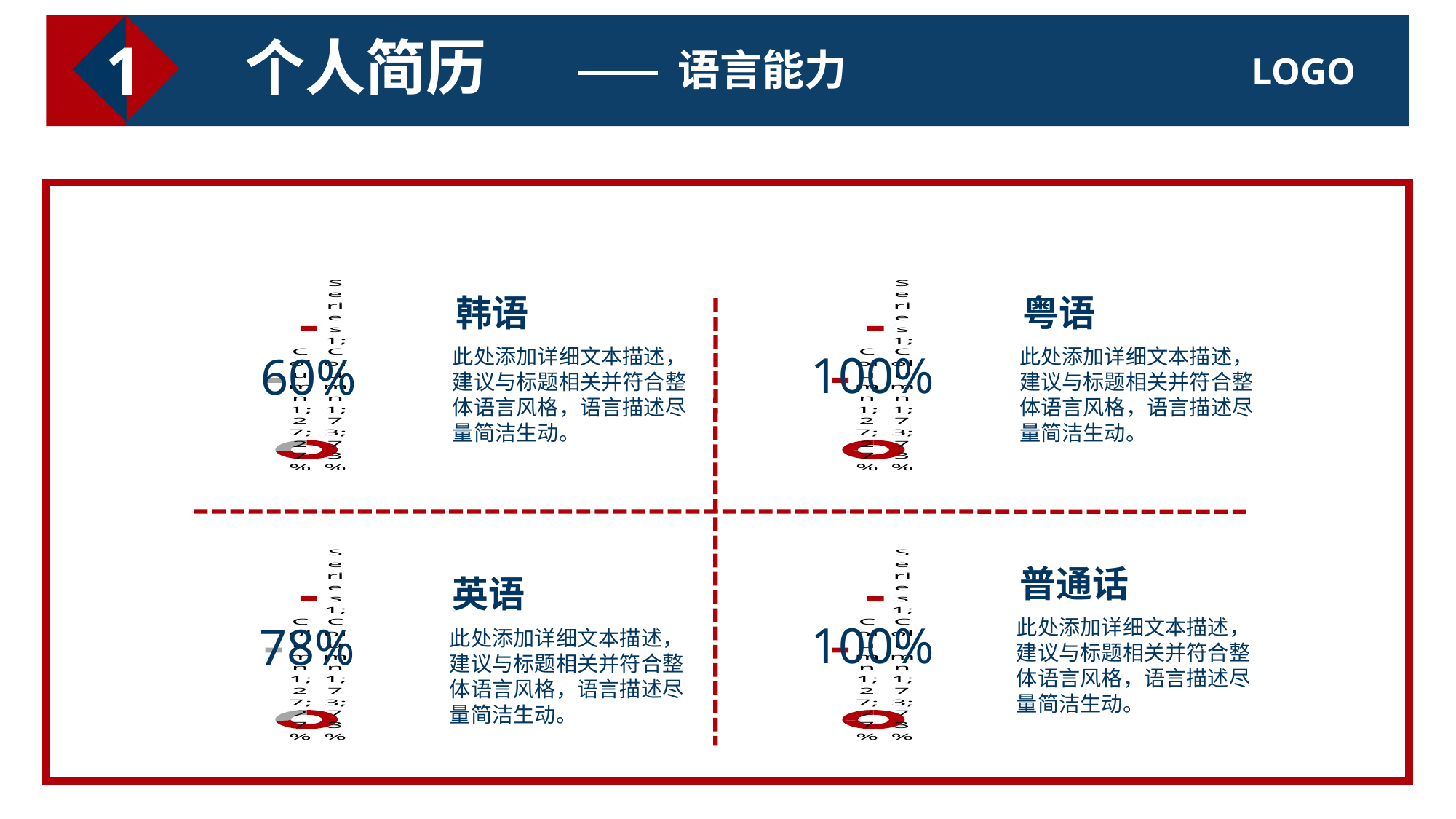
How many small charts are on the slide? 4 What kind of chart is used next to each language? Doughnut chart What is the difference between the percentage for 普通话 and the percentage for 英语? 22% What percentage is shown for 粤语 (Cantonese)? 100% What is the difference between the percentage for 粤语 and the percentage for 韩语? 40% What percentage is shown for 英语 (English)? 78% Which language has the lowest percentage on the slide? 韩语 What percentage is shown for 韩语 (Korean)? 60% What percentage is shown for 普通话 (Mandarin)? 100% Which two languages share the highest percentage on the slide? 粤语 and 普通话 Which is larger, the percentage for 英语 or the percentage for 韩语? 英语 What is the difference between the percentage for 英语 and the percentage for 韩语? 18%